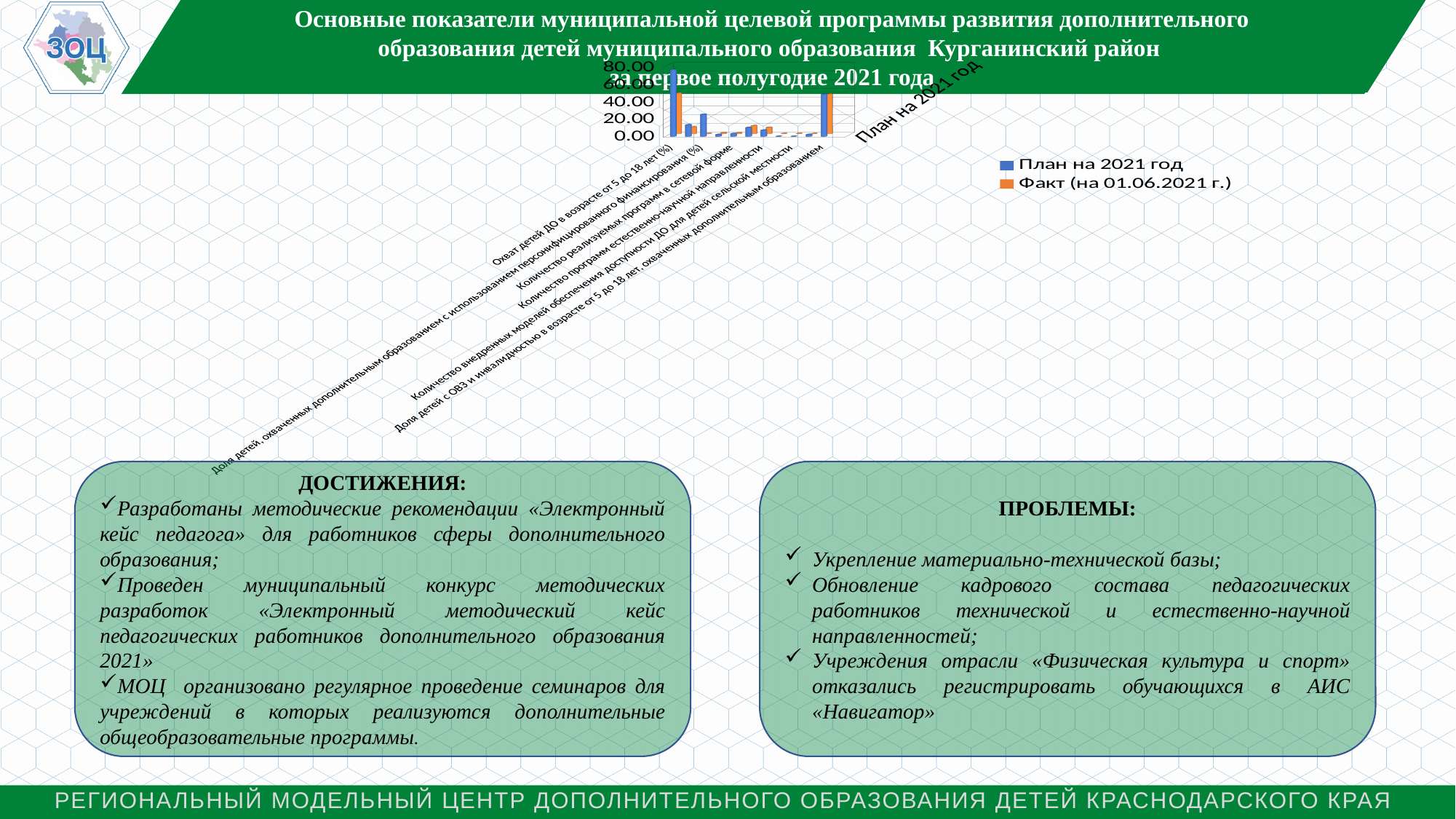
Which series is shown in orange in the chart? Факт (на 01.06.2021 г.) What are the two series named in the chart legend? План на 2021 год; Факт (на 01.06.2021 г.) How many series does the chart legend list? 2 How many categories are plotted along the x axis of the chart? 11 Is the 'План на 2021 год' value for 'Охват детей ДО в возрасте от 5 до 18 лет (%)' greater or less than 40? greater What kind of chart is shown on the slide? bar chart Is the 'План на 2021 год' value for 'Количество реализуемых программ в сетевой форме' greater or less than 20? less